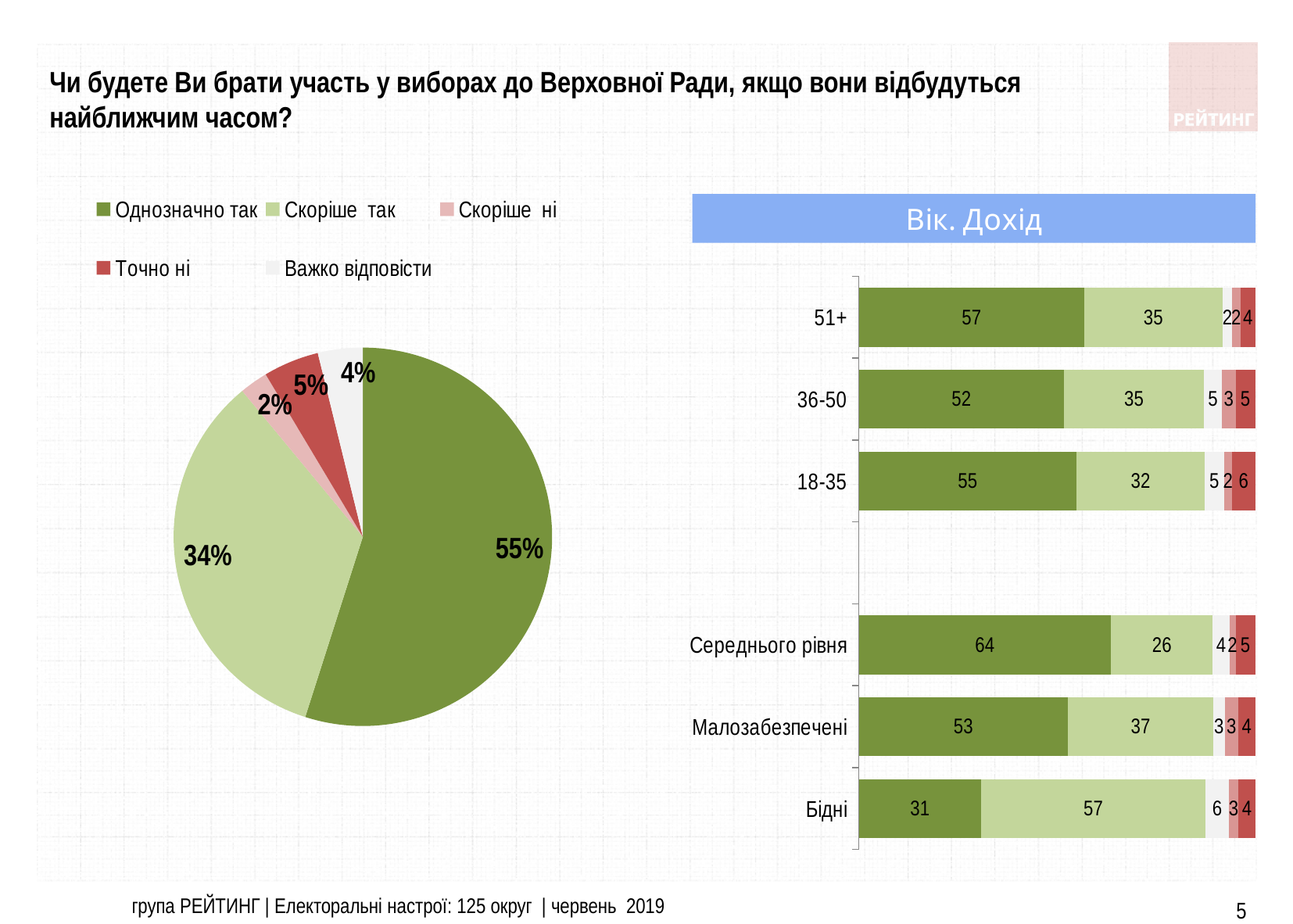
In the bar chart on the right, what is the value of "Скоріше так" for the "Бідні" group? 57 In the pie chart, which answer has the smallest slice? Скоріше ні How many answer options does the legend list? 5 In the bar chart on the right, which is larger: the "Однозначно так" value for 18-35 or for 36-50? 18-35 In the pie chart, what share of respondents answered "Скоріше так"? 34% What kind of chart is on the left side of the slide? pie chart In the bar chart on the right, what is the value of "Однозначно так" for the 51+ age group? 57 In the pie chart, what share of respondents answered "Однозначно так"? 55% In the bar chart on the right, which category has the highest value for "Однозначно так"? Середнього рівня What kind of chart is on the right side of the slide under the heading "Вік. Дохід"? bar chart In the pie chart, what share of respondents answered "Точно ні"? 5% In the bar chart on the right, what is the difference between the "Однозначно так" values for "Середнього рівня" and "Бідні"? 33